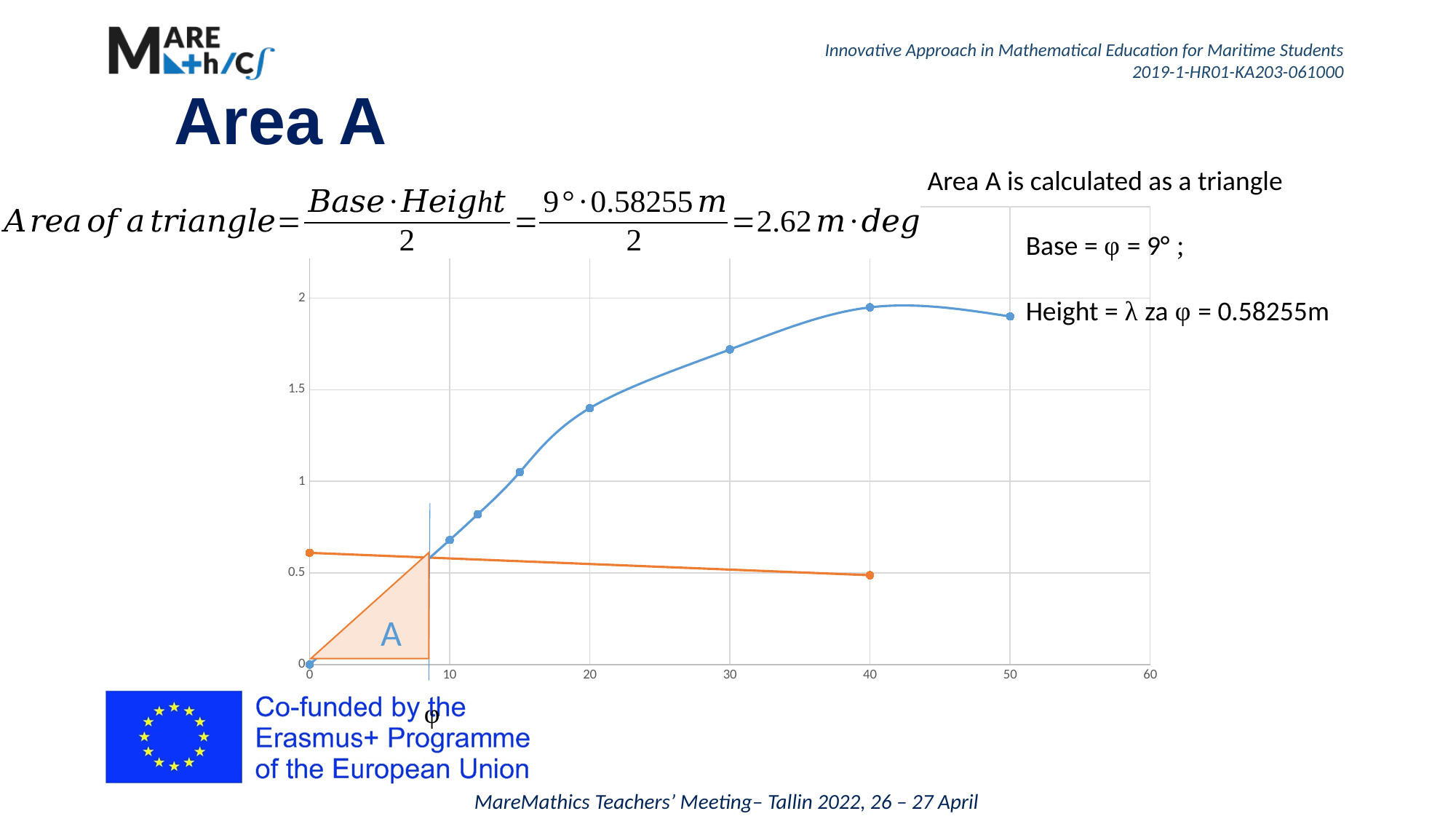
At which x value does the blue series reach its highest point? 40 What kind of chart is shown on the slide? line chart What is the highest tick value shown on the x axis of the chart? 60 Does the blue series rise or fall as x increases from 0 to 40? rise Which is larger: the blue series value at x = 20 or the orange series value at x = 40? the blue series value at x = 20 Is the value of the blue series at x = 30 greater or less than 1.5? greater Is the value of the orange series at x = 0 greater or less than 0.5? greater Is the value of the blue series at x = 10 greater or less than 0.5? greater What is the label printed inside the shaded triangle at the bottom left of the chart? A Does the orange line rise or fall as x increases from 0 to 40? fall